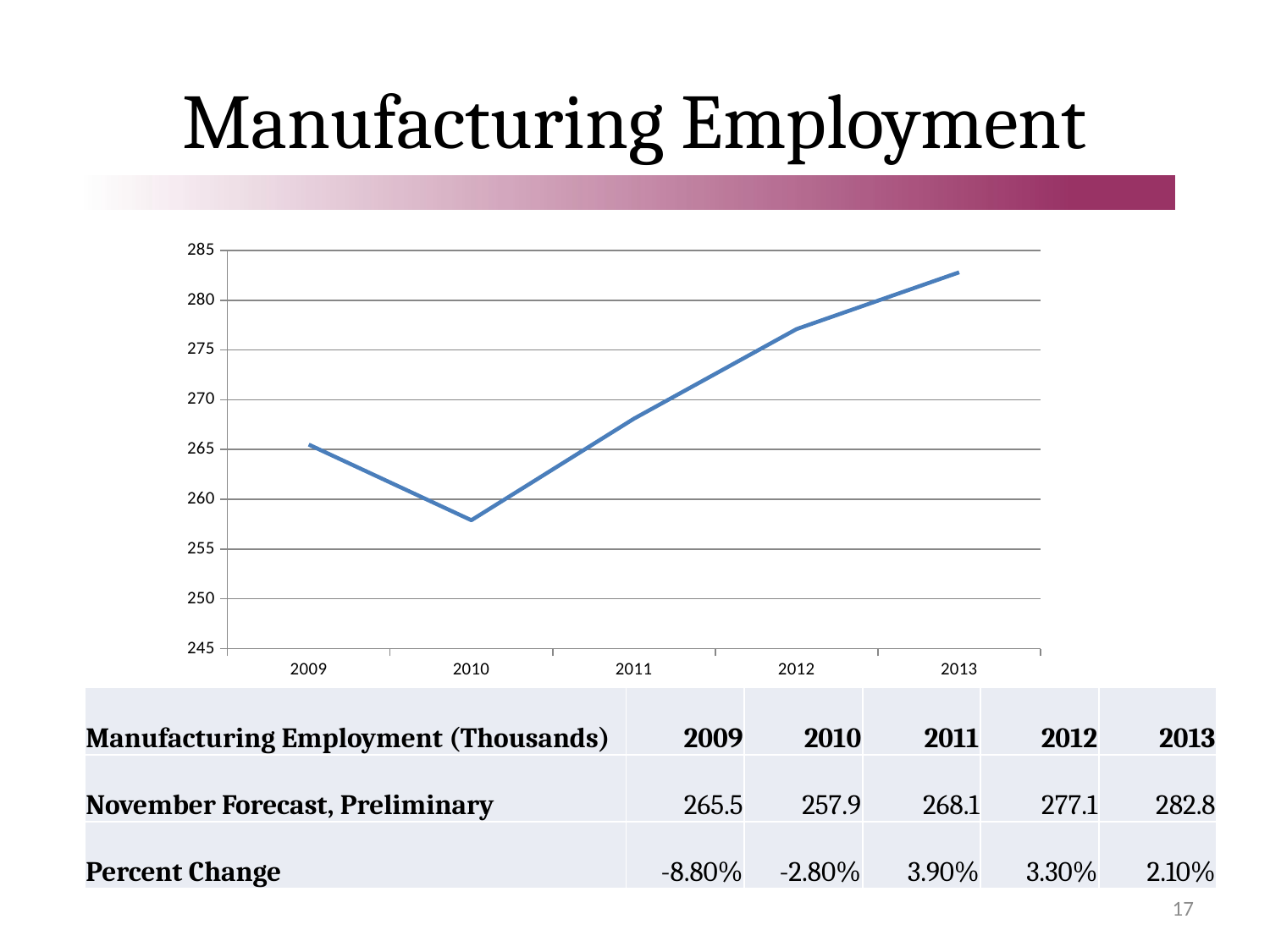
Is the value for 2012 greater or less than 275? greater What is the percent change shown for 2011? 3.90% Does manufacturing employment rise or fall from 2010 to 2013? rise Which year has higher manufacturing employment, 2009 or 2011? 2011 What kind of chart is shown on the slide? line chart Which year has the lowest manufacturing employment? 2010 What is the manufacturing employment value for 2013 (in thousands)? 282.8 How many years are plotted on the x axis of the chart? 5 What is the manufacturing employment value for 2009 (in thousands)? 265.5 Which year has the highest manufacturing employment? 2013 What is the difference in manufacturing employment between 2013 and 2012 (in thousands)? 5.7 What is the manufacturing employment value for 2010 (in thousands)? 257.9